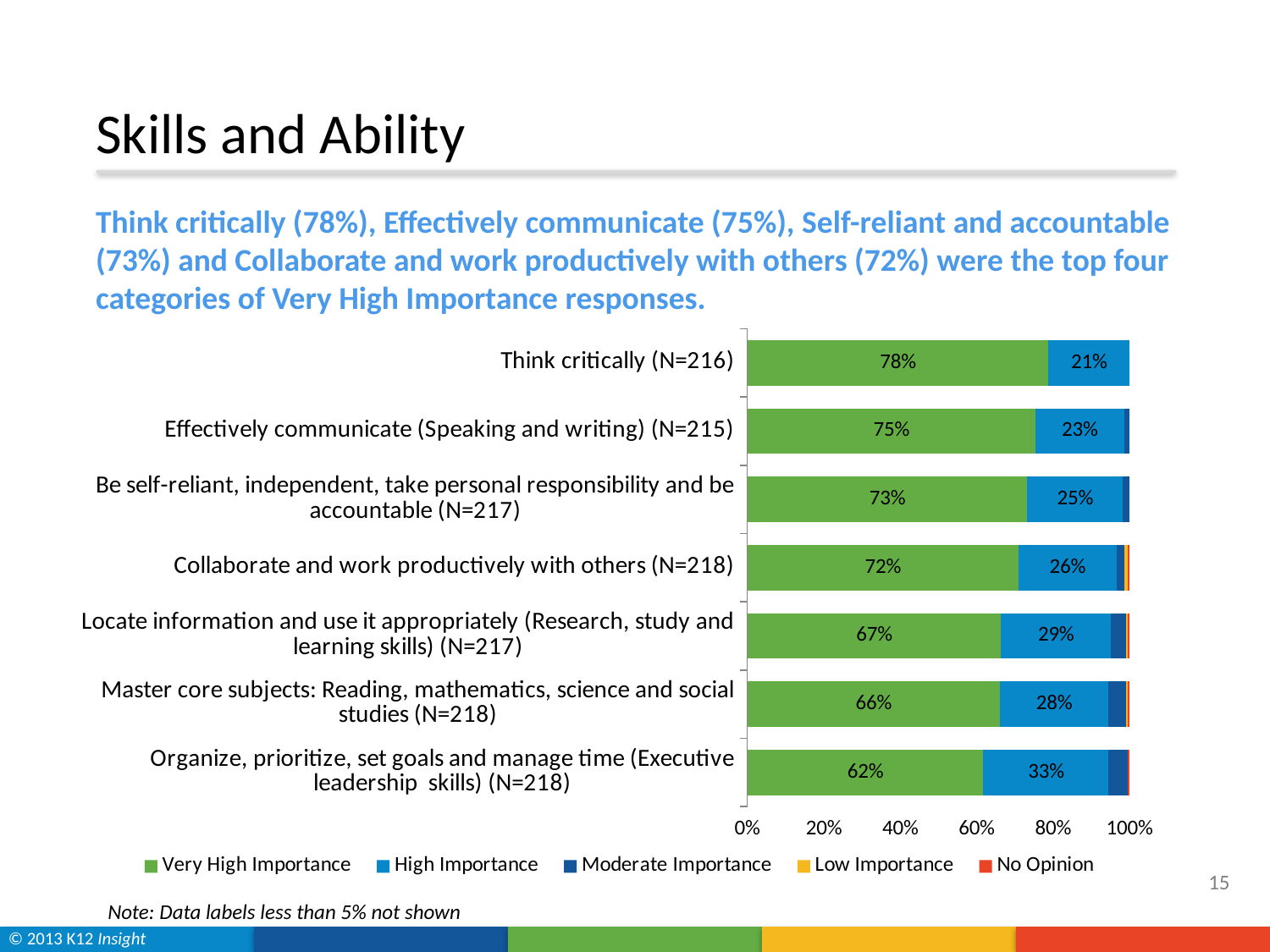
What is the difference in percentage points between the Very High Importance values for 'Think critically' and 'Organize, prioritize, set goals and manage time'? 16 percentage points What percentage of respondents rated 'Think critically (N=216)' as Very High Importance? 78% Which colour represents 'Very High Importance' in the legend? Green How many skill categories are shown in the chart? 7 What type of chart is shown on the slide? Stacked bar chart How many series does the legend list? 5 Which has a larger High Importance value: 'Organize, prioritize, set goals and manage time' or 'Locate information and use it appropriately'? Organize, prioritize, set goals and manage time What is the High Importance value for 'Collaborate and work productively with others (N=218)'? 26% What is the Very High Importance value for 'Master core subjects: Reading, mathematics, science and social studies (N=218)'? 66% Which category has the lowest Very High Importance percentage? Organize, prioritize, set goals and manage time (Executive leadership skills) (N=218) Which category has the highest Very High Importance percentage? Think critically (N=216) What is the High Importance value for 'Organize, prioritize, set goals and manage time (Executive leadership skills) (N=218)'? 33%